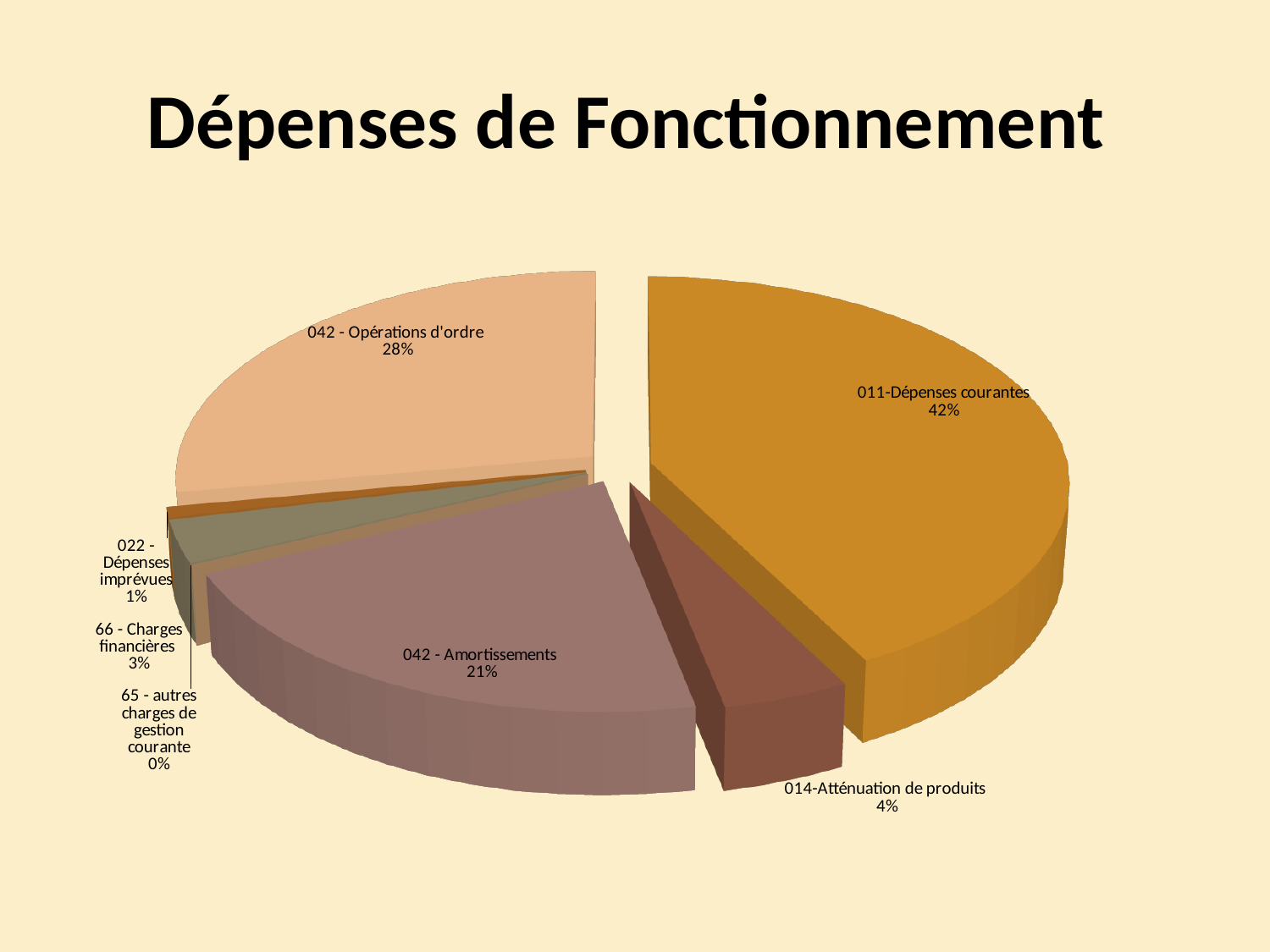
What share of the pie does 042 - Amortissements represent? 21% What share of the pie does 011-Dépenses courantes represent? 42% What share of the pie does 022 - Dépenses imprévues represent? 1% What kind of chart is shown on the slide? Pie chart What is the difference in percentage points between 011-Dépenses courantes and 042 - Opérations d'ordre? 14 percentage points How many categories are shown in the pie chart? 7 Which category has the smallest share of the pie? 65 - autres charges de gestion courante What is the title of the chart? Dépenses de Fonctionnement Which category has the largest share of the pie? 011-Dépenses courantes